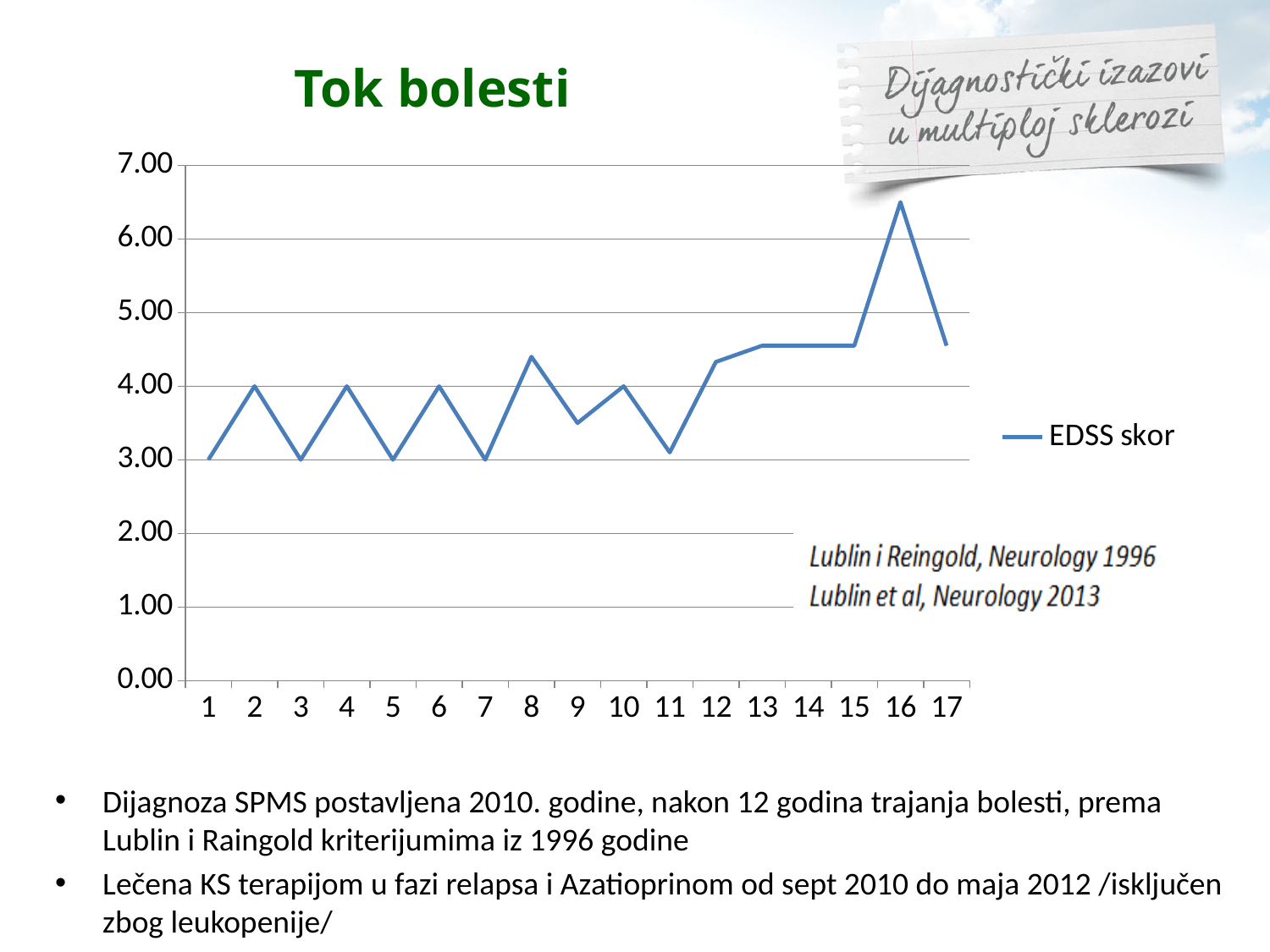
Is the EDSS skor value at point 9 greater or less than 4.00? less Between point 11 and point 16, does the EDSS skor line rise or fall? rise What kind of chart is shown on the slide? line chart What is the EDSS skor value at point 1? 3.00 What is the EDSS skor value at point 7? 3.00 At which x-axis point does the EDSS skor reach its highest value? 16 Which has the larger EDSS skor value, point 8 or point 9? point 8 How many points are plotted along the x axis? 17 What is the EDSS skor value at point 2? 4.00 How many series does the legend list? 1 Is the EDSS skor value at point 16 greater or less than 6.00? greater What is the name of the series shown in the legend? EDSS skor